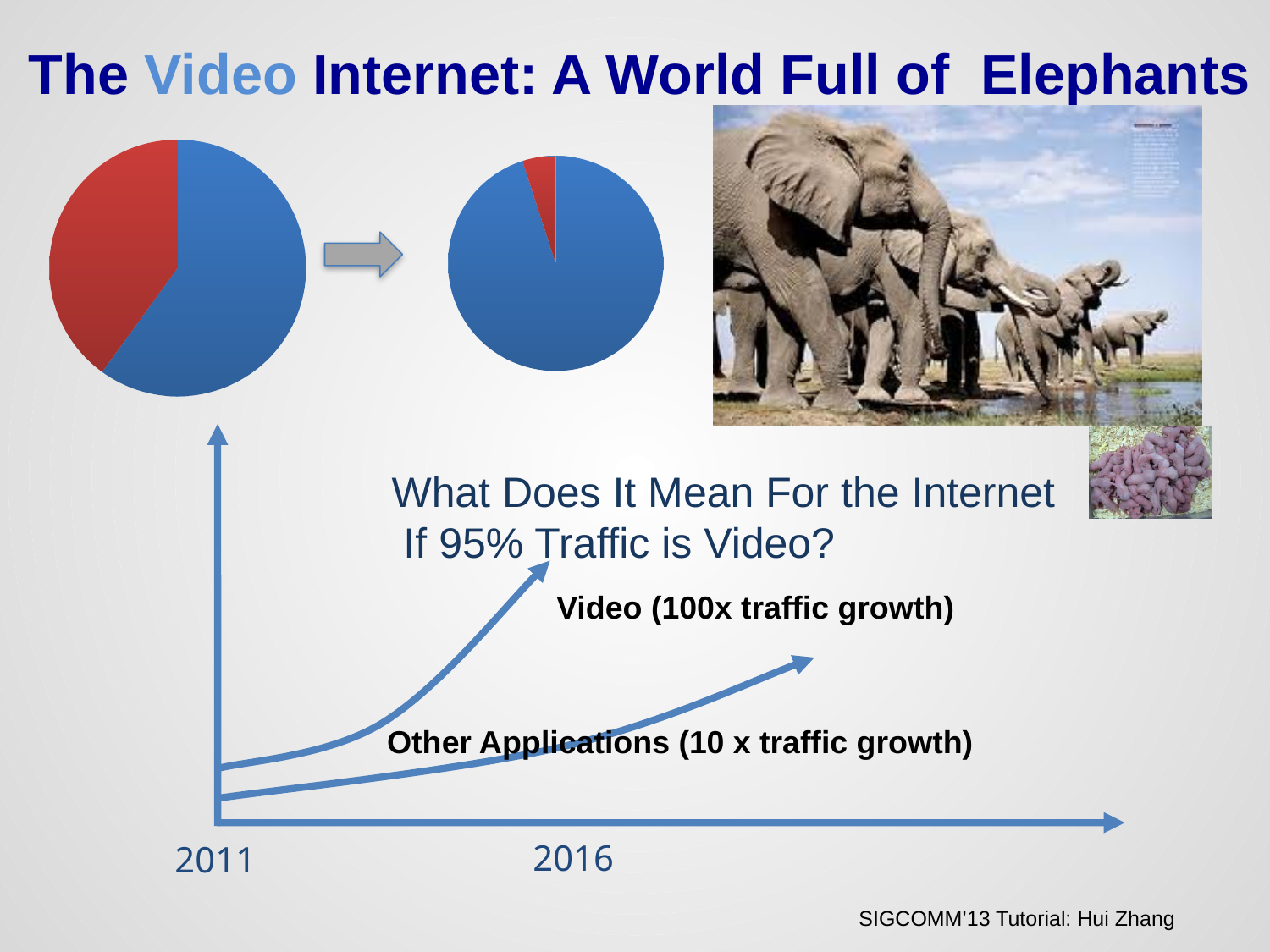
In the line diagram at the bottom of the slide, do the lines rise or fall from 2011 to 2016? rise In the right pie chart, which slice is smaller, the blue one or the red one? red What traffic growth factor is given for Video in the line diagram at the bottom of the slide? 100x Comparing the two pie charts, does the red slice get larger or smaller from the left pie chart to the right pie chart? smaller How many years are labelled on the x axis of the line diagram at the bottom of the slide? 2 What traffic growth factor is given for Other Applications in the line diagram at the bottom of the slide? 10 x In the left pie chart, which slice is larger, the blue one or the red one? blue In the line diagram at the bottom of the slide, which line is higher at the right end, Video or Other Applications? Video What kind of chart is the chart to the right of the grey arrow at the top of the slide? pie chart What kind of chart is the left chart at the top of the slide? pie chart How many slices does the left pie chart have? 2 How many slices does the right pie chart have? 2